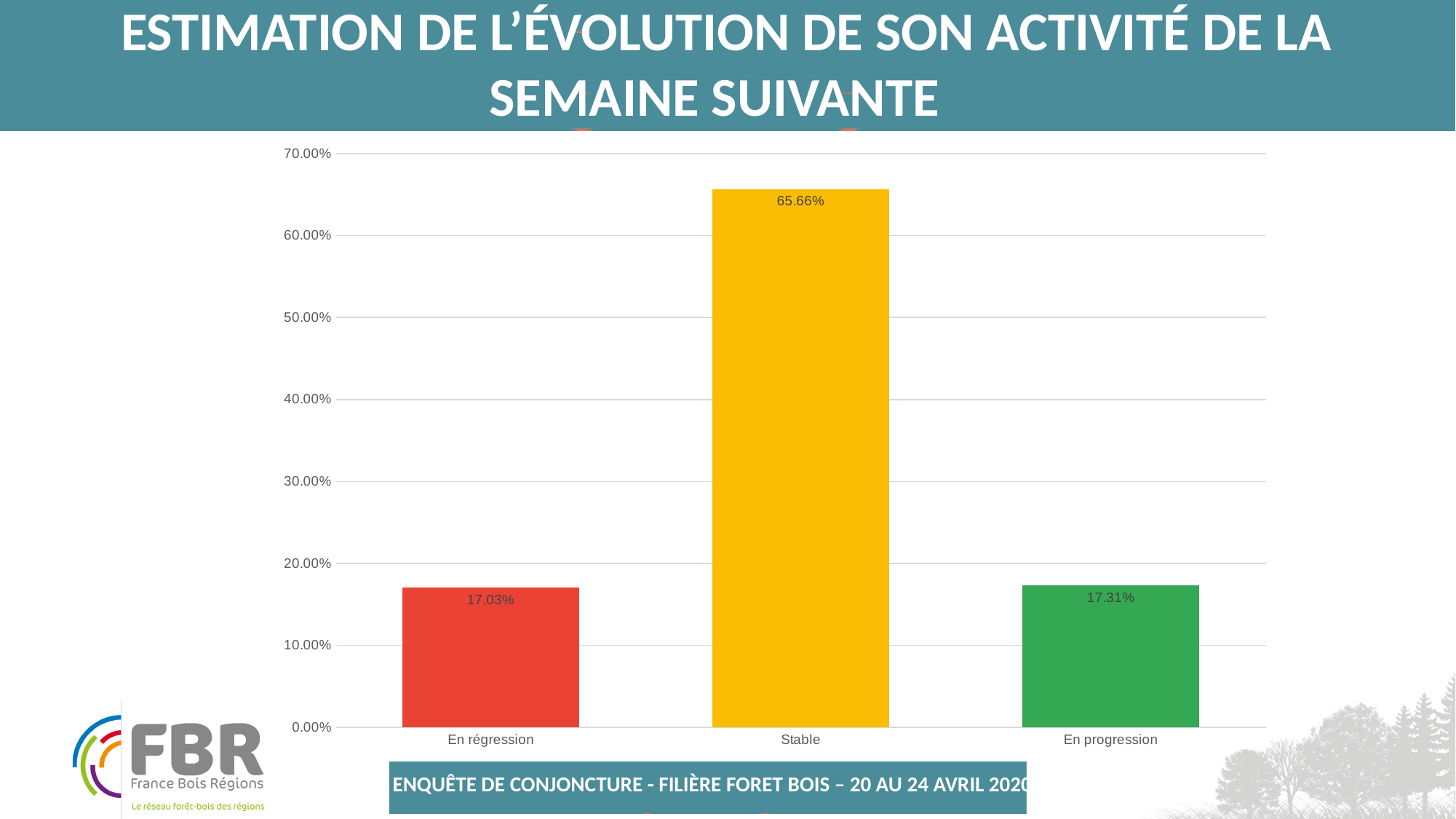
Is the value for Stable greater or less than 60.00%? greater What is the difference between the values for En progression and En régression? 0.28% What is the value for En régression? 17.03% What kind of chart is shown on the slide? bar chart What is the value for En progression? 17.31% What is the value for Stable? 65.66% Which category has the highest value? Stable Which category has the lowest value? En régression How many categories are shown on the x axis? 3 Which is larger, the value for Stable or the value for En progression? Stable What colour is the bar for Stable? yellow What is the difference between the values for Stable and En régression? 48.63%